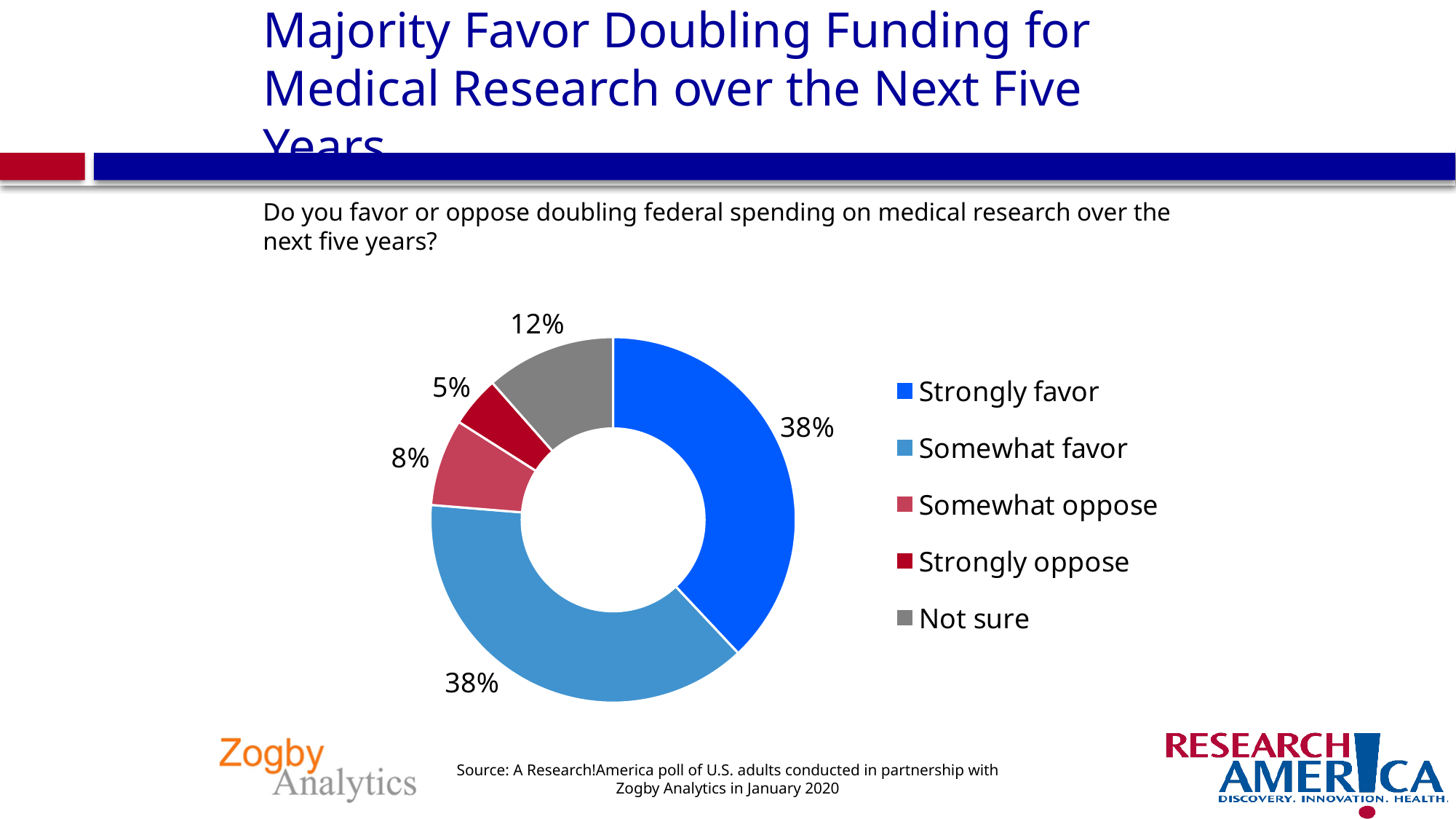
What percentage of respondents said they strongly favor doubling federal spending on medical research? 38% What colour represents the Not sure category in the chart? Gray Which response category has the smallest share of the chart? Strongly oppose What is the combined percentage of respondents who strongly favor or somewhat favor? 76% How many response categories are shown in the chart? 5 What percentage of respondents said they somewhat oppose doubling federal spending on medical research? 8% Which is larger: the share for Not sure or the share for Somewhat oppose? Not sure What type of chart is shown on the slide? Pie chart (doughnut) What is the difference in percentage points between Not sure and Strongly oppose? 7% What percentage of respondents said they strongly oppose? 5% Which is larger: the share for Somewhat oppose or the share for Strongly oppose? Somewhat oppose What percentage of respondents said they were not sure? 12%